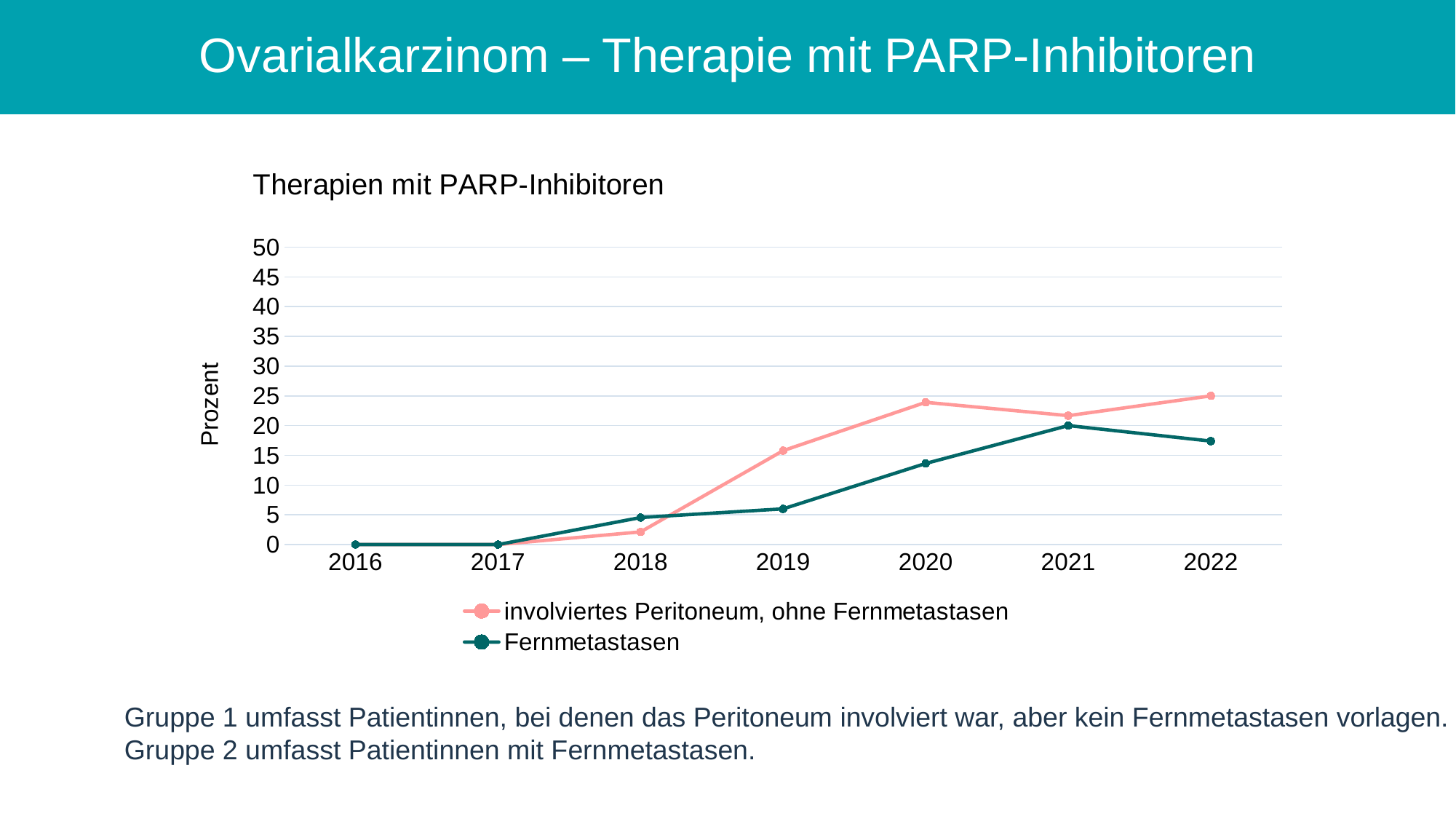
What is the value for Fernmetastasen in 2016? 0 What kind of chart is shown on the slide? line chart Is the value for involviertes Peritoneum, ohne Fernmetastasen in 2020 greater or less than 20? greater How many years are shown on the x axis? 7 What is the title of the chart? Therapien mit PARP-Inhibitoren Does the Fernmetastasen series rise or fall from 2017 to 2021? rise How many series does the legend list? 2 Is the value for Fernmetastasen in 2019 greater or less than 10? less In 2022, which series has the higher value: involviertes Peritoneum, ohne Fernmetastasen or Fernmetastasen? involviertes Peritoneum, ohne Fernmetastasen In which year does the involviertes Peritoneum, ohne Fernmetastasen series reach its highest value? 2022 What is the value for involviertes Peritoneum, ohne Fernmetastasen in 2017? 0 What is the label of the y axis? Prozent